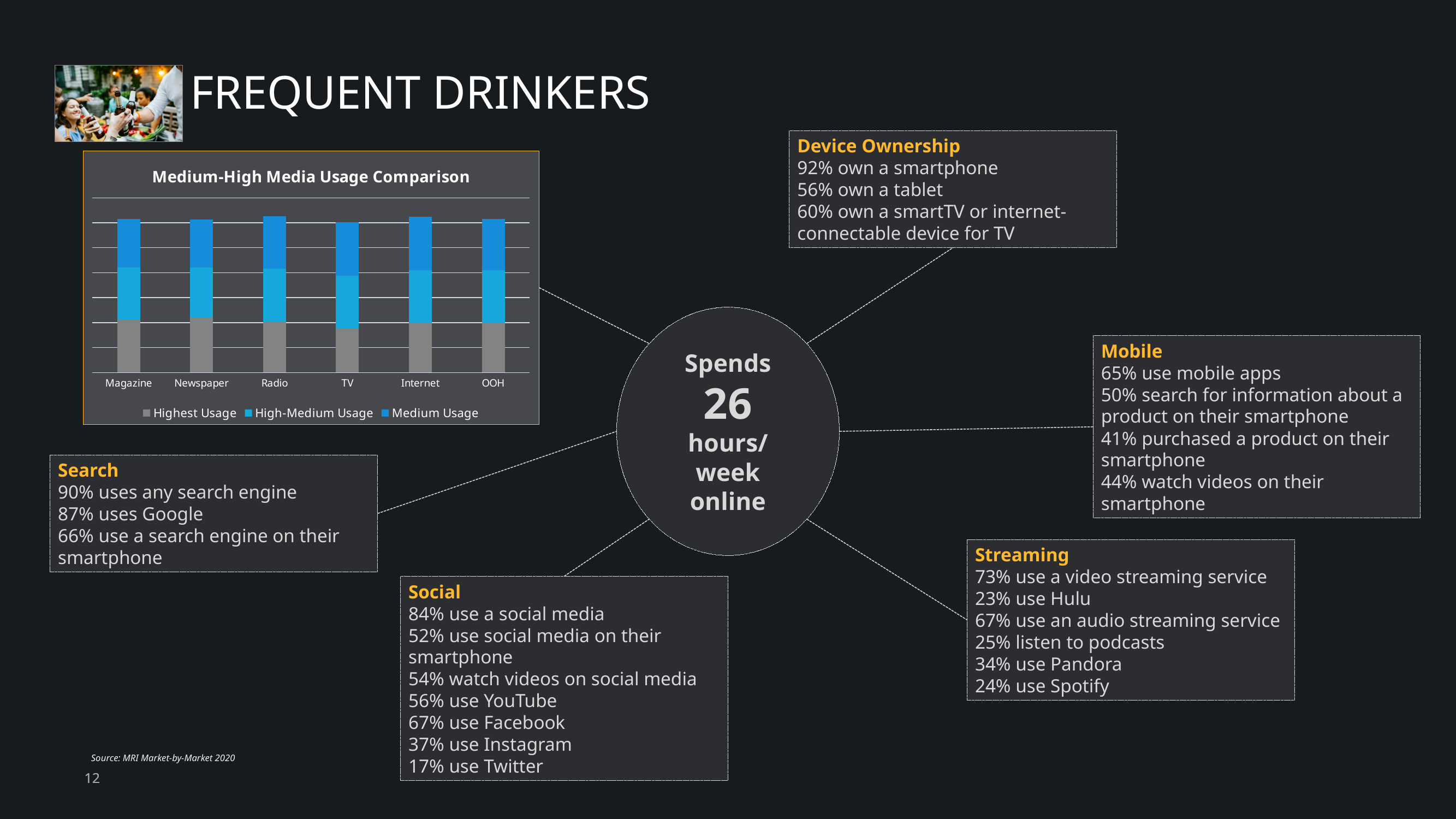
In the Medium-High Media Usage Comparison chart, is the total stacked bar for Radio or for TV taller? Radio How many series does the legend of the Medium-High Media Usage Comparison chart list? 3 What is the last category on the x axis of the Medium-High Media Usage Comparison chart? OOH Which series in the Medium-High Media Usage Comparison chart is shown in grey? Highest Usage In the Medium-High Media Usage Comparison chart, which category has the smallest Highest Usage segment? TV How many media categories are shown on the x axis of the Medium-High Media Usage Comparison chart? 6 What is the first category on the x axis of the Medium-High Media Usage Comparison chart? Magazine In the Medium-High Media Usage Comparison chart, which category has the lowest total stacked bar? TV What is the title of the chart on the slide? Medium-High Media Usage Comparison What kind of chart is the Medium-High Media Usage Comparison chart? Stacked bar chart In the Medium-High Media Usage Comparison chart, is the Highest Usage segment for Newspaper or for TV larger? Newspaper